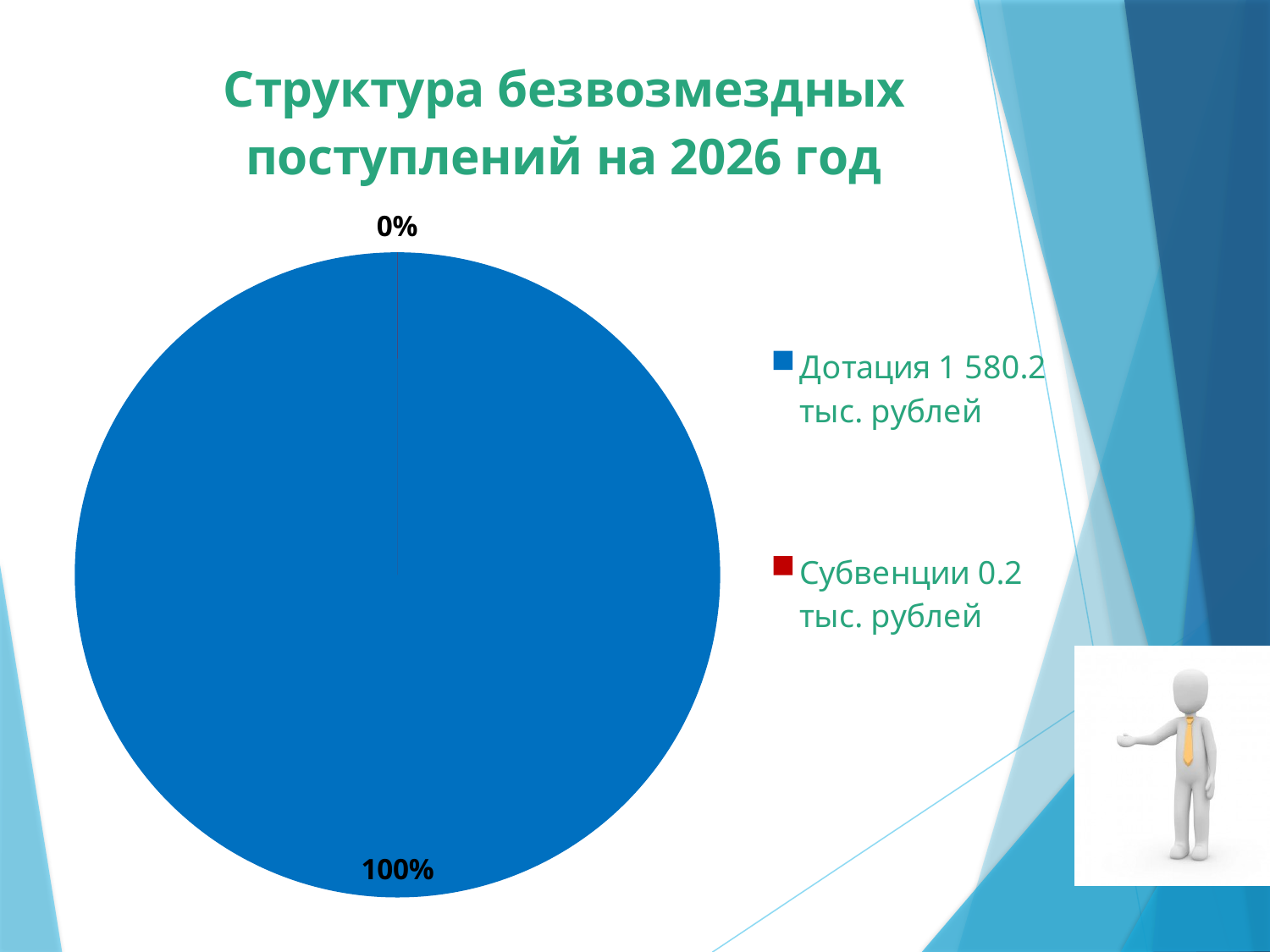
How many slices (categories) does the pie chart have? 2 What kind of chart is shown on the slide? pie chart What amount is given for Дотация in the legend? 1 580.2 тыс. рублей Which is larger, Дотация or Субвенции? Дотация What share of the pie does Субвенции account for? 0% What share of the pie does Дотация account for? 100% What is the title of the chart? Структура безвозмездных поступлений на 2026 год What colour represents Дотация in the legend? blue Which category has the largest share of the pie? Дотация Which category has the smallest share of the pie? Субвенции What amount is given for Субвенции in the legend? 0.2 тыс. рублей How many entries does the legend list? 2